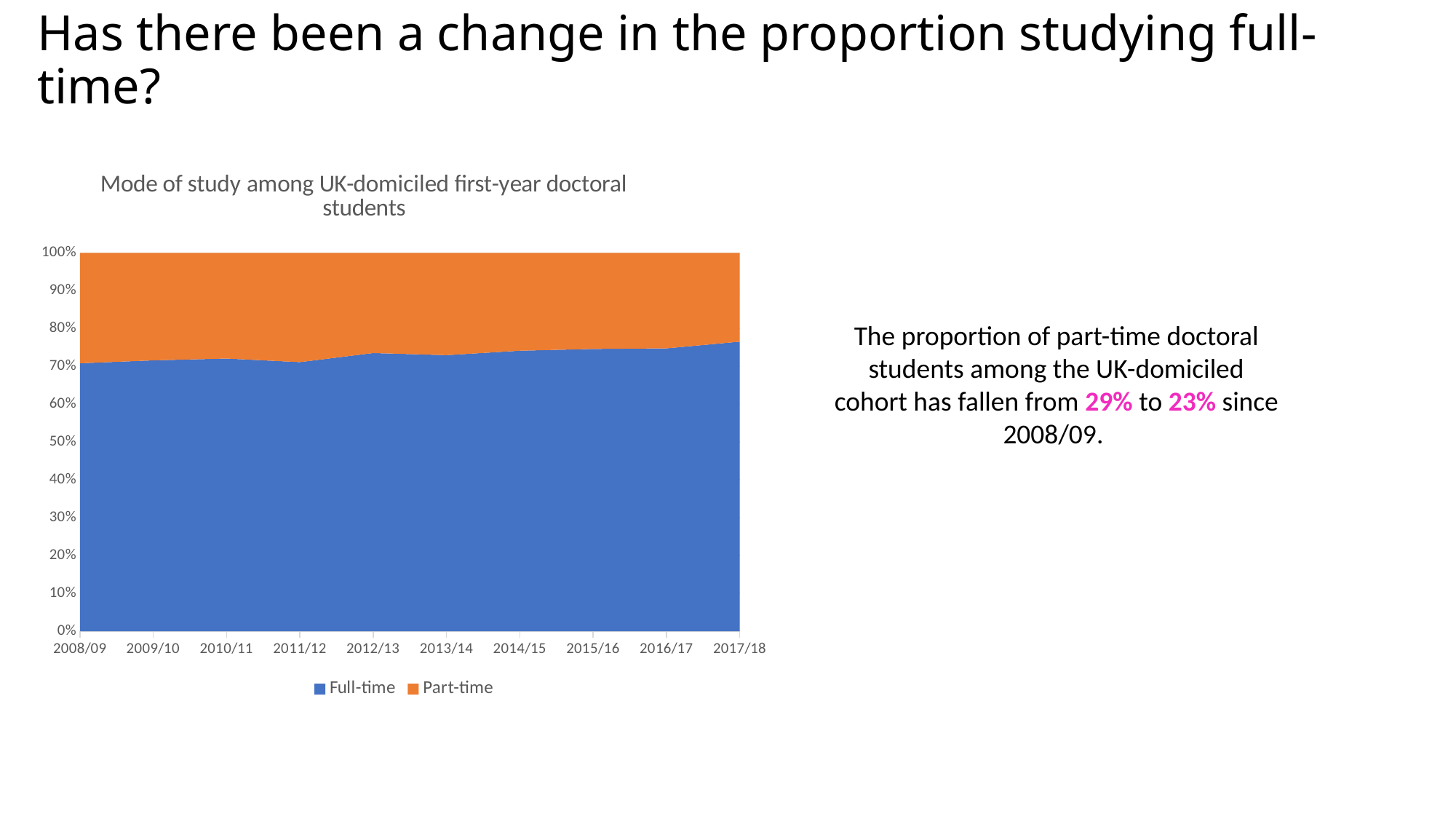
In which year is the Full-time share highest? 2017/18 Does the Full-time share rise or fall from 2008/09 to 2017/18? Rise Is the Full-time share in 2017/18 greater or less than 70%? greater In which year is the Part-time share lowest? 2017/18 How many academic years are shown on the x axis? 10 Which series is shown in orange? Part-time In 2017/18, which is larger, the Full-time share or the Part-time share? Full-time Is the Full-time share in 2017/18 greater or less than 80%? less What type of chart is shown on the slide? Area chart What is the title of the chart? Mode of study among UK-domiciled first-year doctoral students Is the Part-time share in 2008/09 greater or less than 20%? greater How many series does the legend list? 2